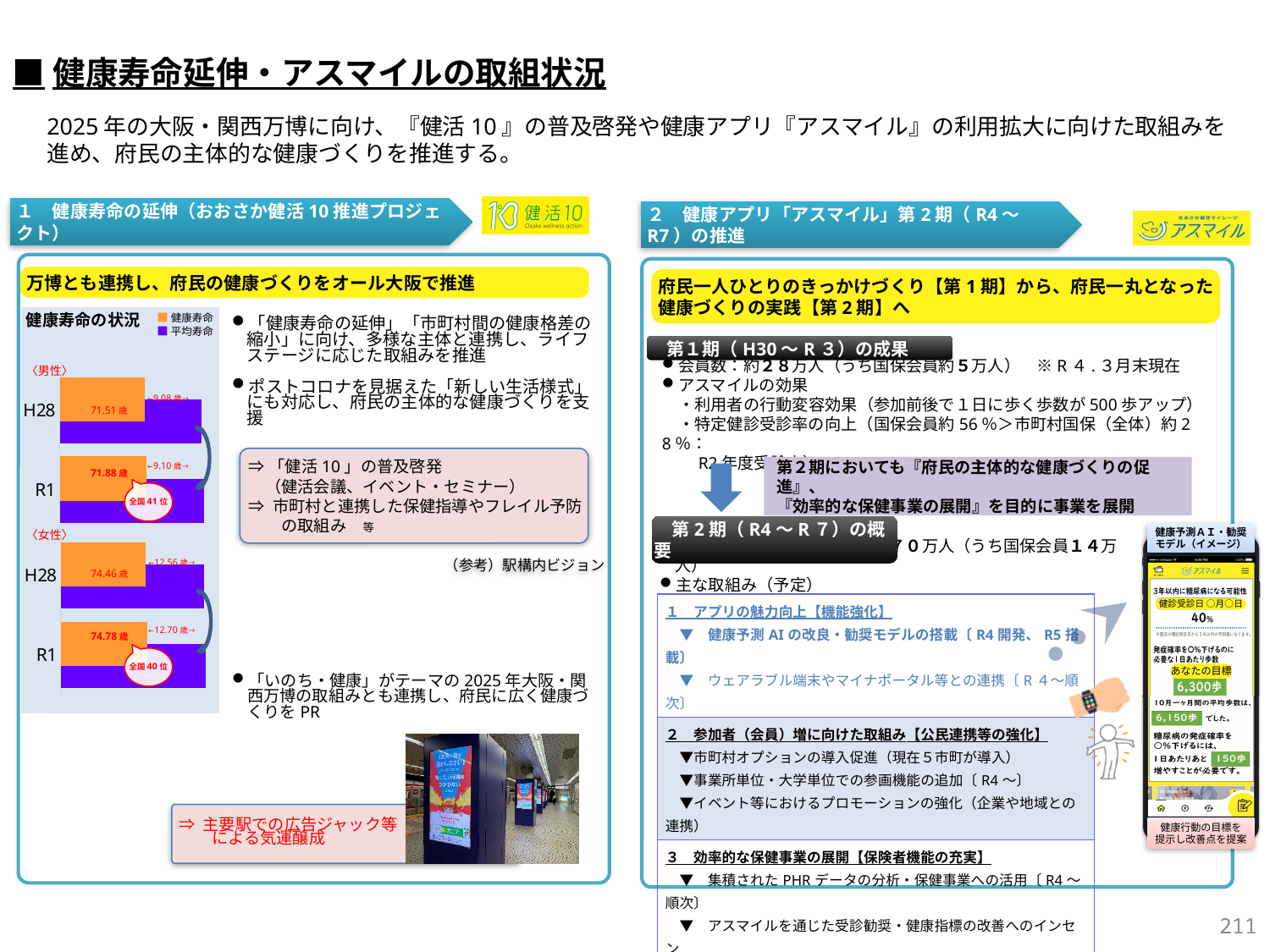
In the 健康寿命の状況 chart, what is the gap between average life expectancy and healthy life expectancy for women in H28? 12.56歳 In the 健康寿命の状況 chart, what is the national ranking shown for women in R1? 全国40位 How many series does the legend of the 健康寿命の状況 chart list? 2 What is the healthy life expectancy (健康寿命) for women in R1 shown in the 健康寿命の状況 chart? 74.78歳 What is the healthy life expectancy (健康寿命) for women in H28 shown in the 健康寿命の状況 chart? 74.46歳 What is the healthy life expectancy (健康寿命) for men in H28 shown in the 健康寿命の状況 chart? 71.51歳 What kind of chart is the 健康寿命の状況 chart? Bar chart In the 健康寿命の状況 chart, which colour represents 平均寿命? Purple In the 健康寿命の状況 chart, what is the gap between average life expectancy and healthy life expectancy for men in R1? 9.10歳 In the 健康寿命の状況 chart, which is larger: the healthy life expectancy for women in R1 or for men in R1? Women in R1 In the 健康寿命の状況 chart, did men's healthy life expectancy rise or fall from H28 to R1? Rise What is the healthy life expectancy (健康寿命) for men in R1 shown in the 健康寿命の状況 chart? 71.88歳